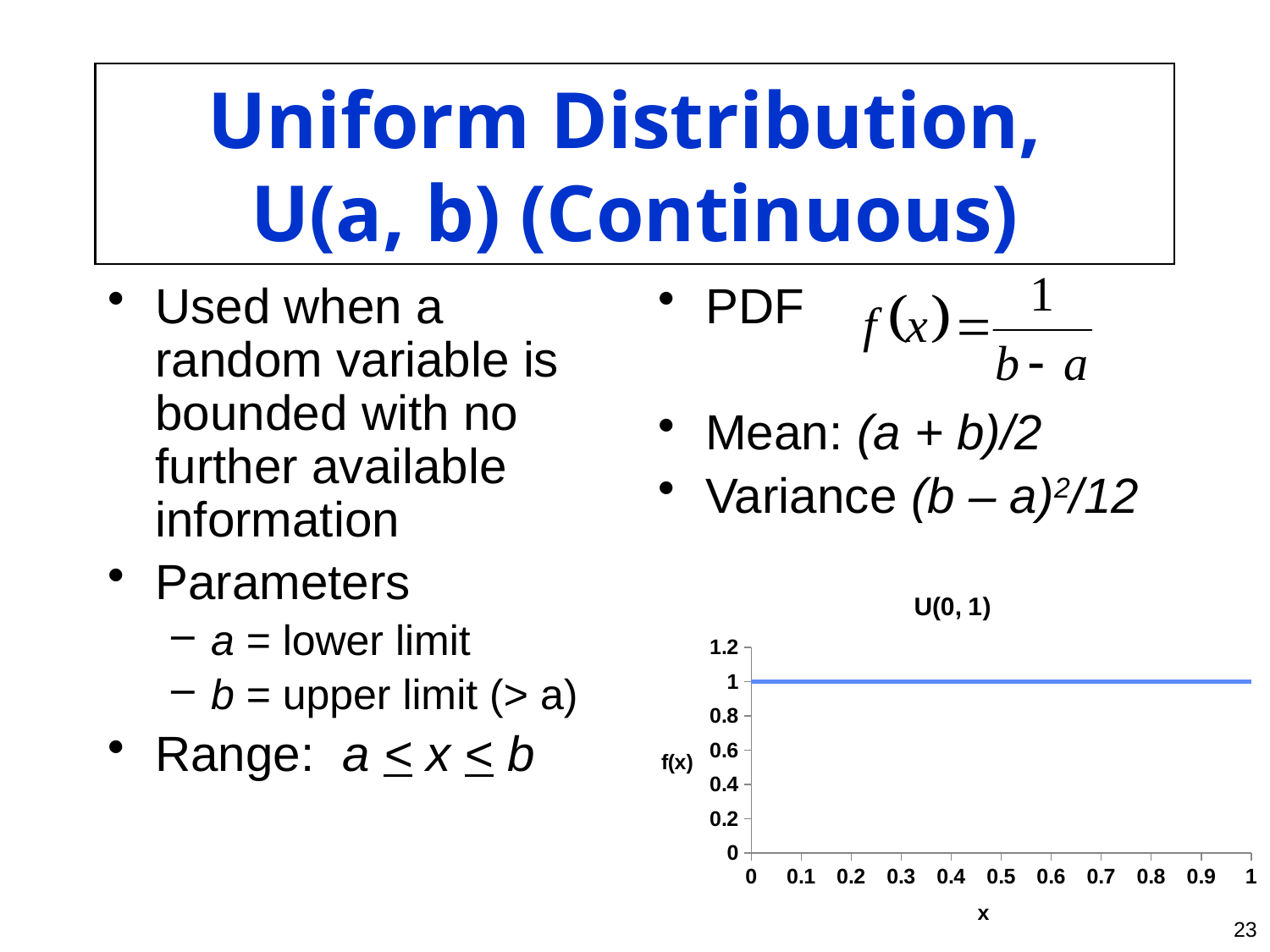
What kind of chart is shown on the slide? line chart Does the plotted line rise, fall, or stay constant as x increases from 0 to 1? stays constant Is the value of f(x) at x = 0.3 greater or less than 0.8? greater What is the title of the chart? U(0, 1) Is the value of f(x) at x = 0.7 greater or less than 1.2? less What is the value of f(x) at x = 0.5 in the chart? 1 What is the value of f(x) at x = 0 in the chart? 1 What label is shown on the vertical axis of the chart? f(x) How many tick labels are shown on the x axis of the chart? 11